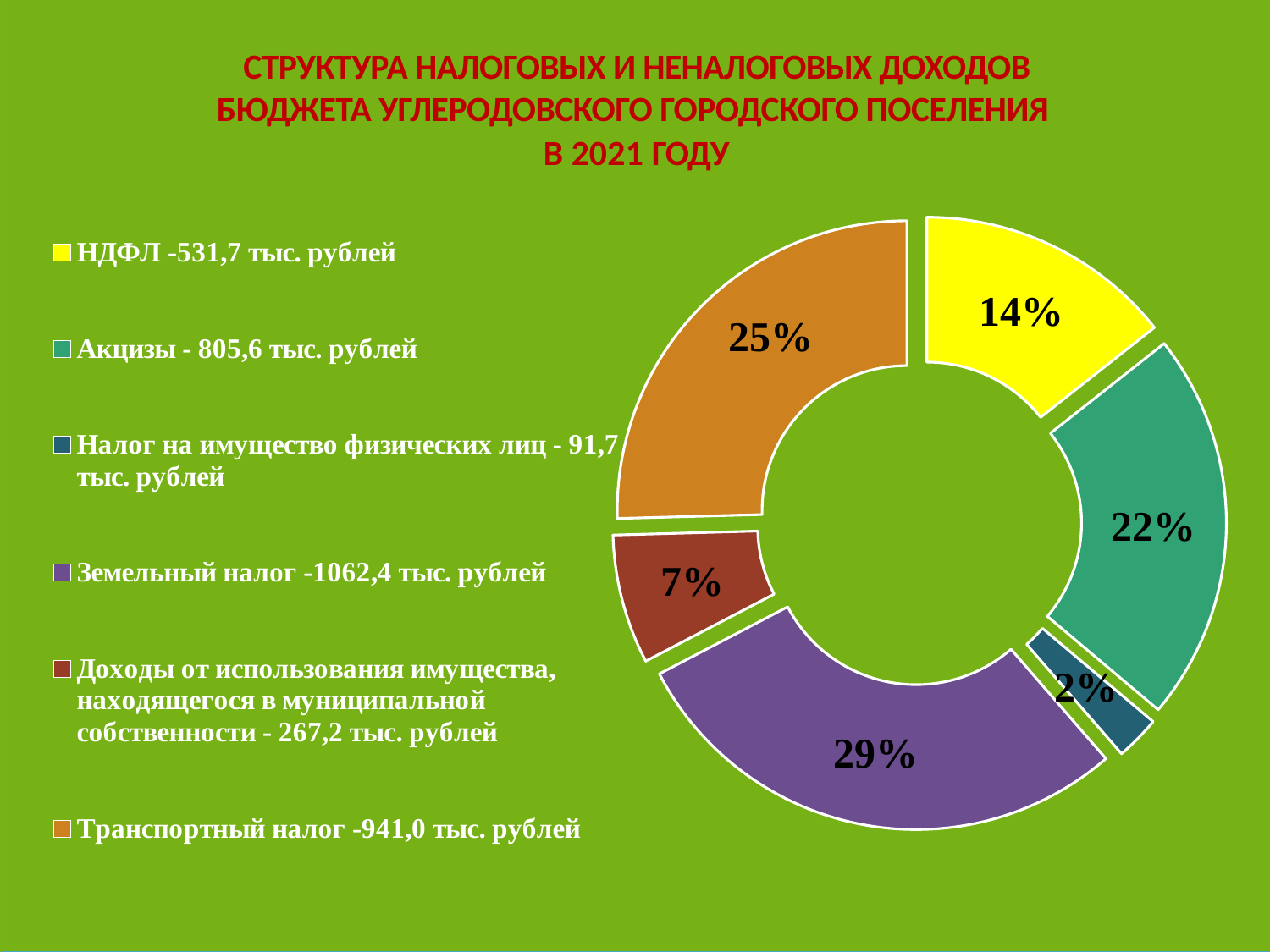
Which category has the smallest share of the chart? Налог на имущество физических лиц What is the difference in percentage points between the Земельный налог share and the Транспортный налог share? 4 percentage points Which category has the largest share of the chart? Земельный налог What colour is the slice for Земельный налог? Purple Which has a larger share, Акцизы or НДФЛ? Акцизы What share does Транспортный налог have in the chart? 25% What kind of chart is shown on the slide? Doughnut (pie) chart What percentage is shown for the НДФЛ slice? 14% According to the legend, what is the amount for Транспортный налог? 941,0 тыс. рублей What percentage is shown for Акцизы? 22% How many categories are shown in the chart? 6 What share of the chart does Земельный налог account for? 29%